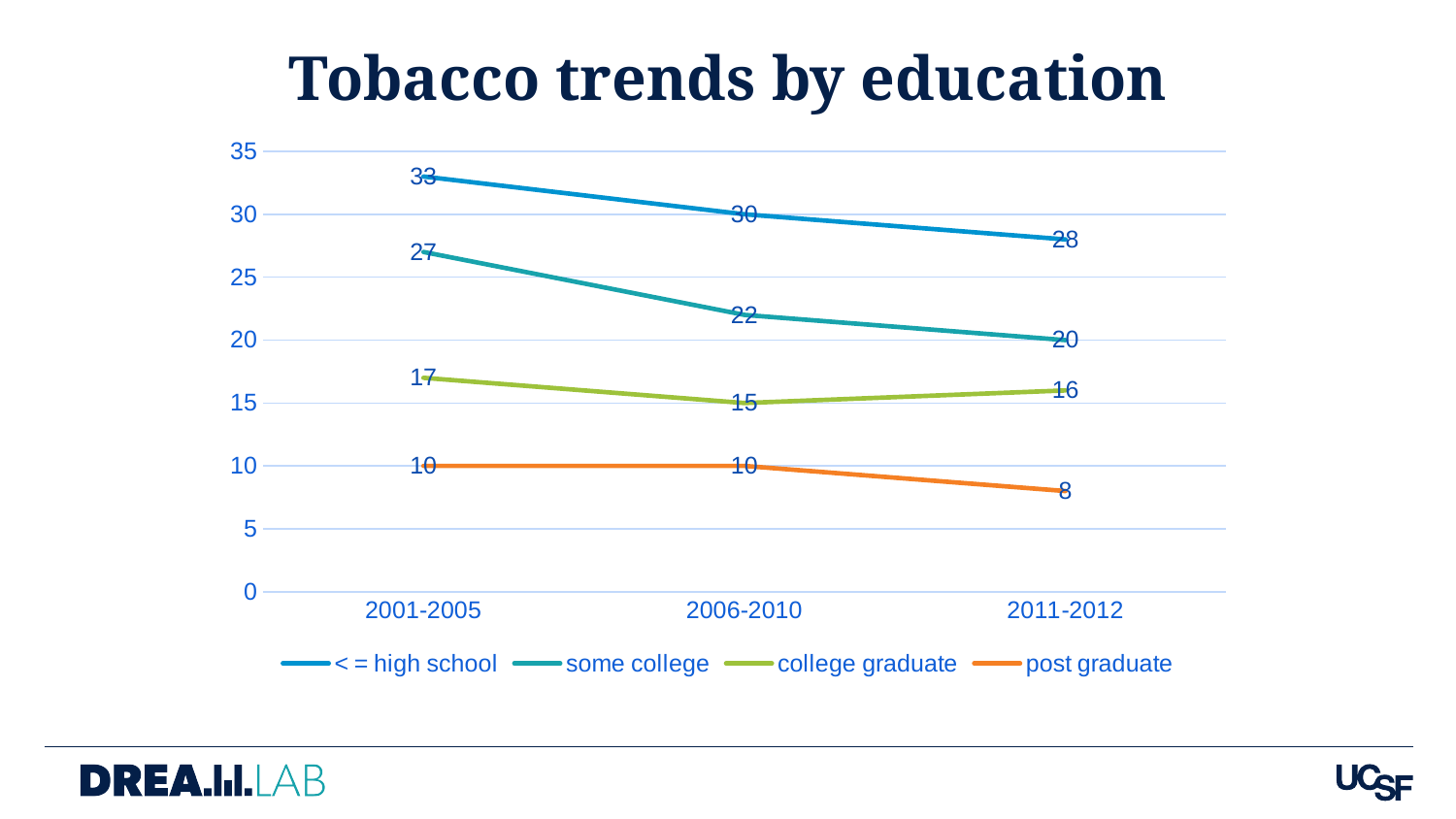
How many series does the legend list? 4 What is the value for "college graduate" in 2011-2012? 16 What is the value for "< = high school" in 2001-2005? 33 What is the value for "some college" in 2006-2010? 22 How many time periods are shown on the x axis? 3 What is the difference between the "< = high school" value and the "some college" value in 2001-2005? 6 Which is larger: the "college graduate" value in 2006-2010 or the "post graduate" value in 2006-2010? college graduate Does the "some college" series rise or fall from 2001-2005 to 2011-2012? fall What is the value for "post graduate" in 2011-2012? 8 Which series has the lowest value in 2001-2005? post graduate What kind of chart is shown on the slide? line chart Which series has the highest value in 2011-2012? < = high school